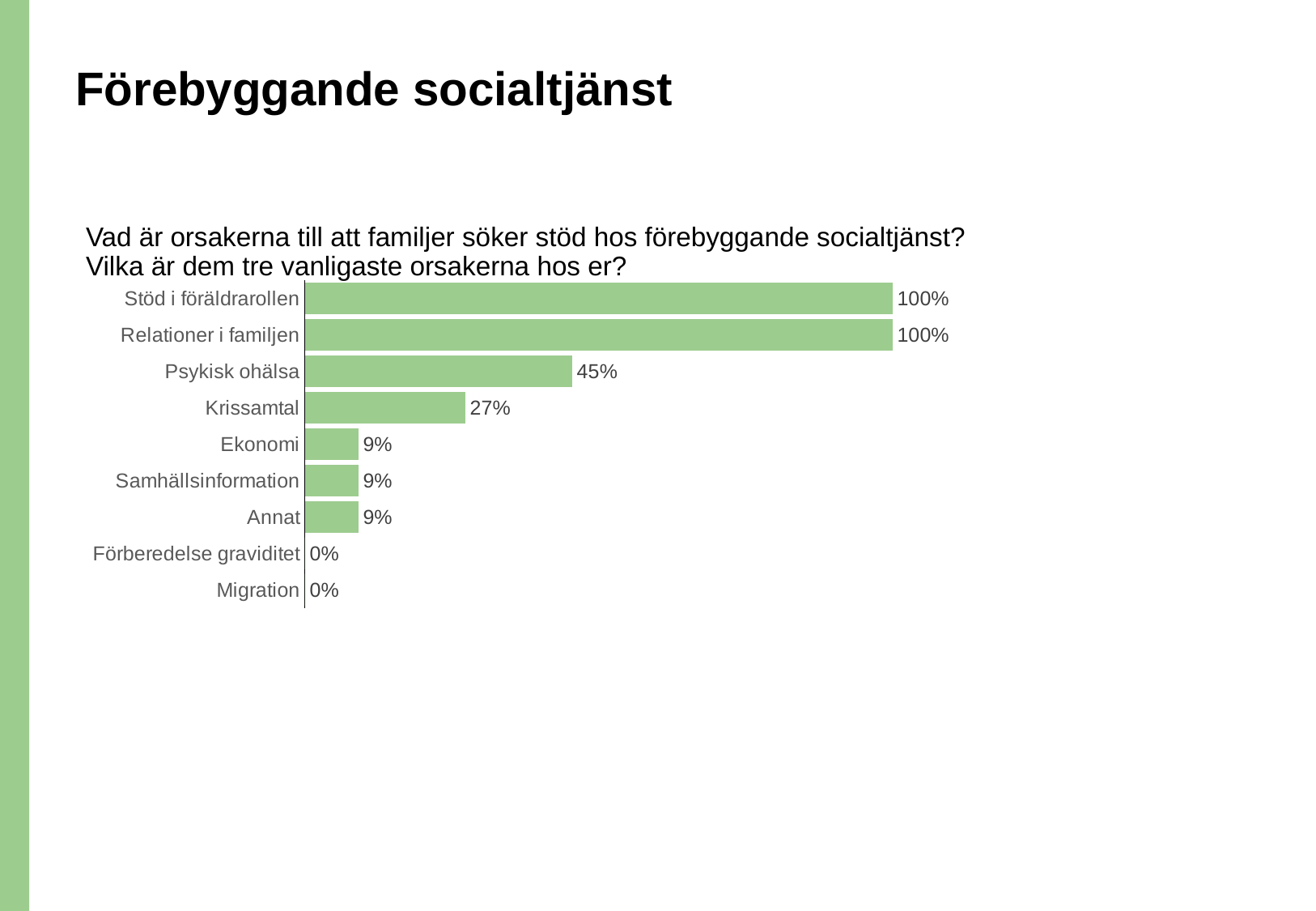
How many categories have a value of 100%? 2 Which category has the lowest value among those with a non-zero value? Ekonomi, Samhällsinformation and Annat (9%) What is the difference between the values for Stöd i föräldrarollen and Psykisk ohälsa? 55% What is the value for Psykisk ohälsa? 45% What colour are the bars in the chart? Green What kind of chart is shown on the slide? Bar chart What is the value for Ekonomi? 9% Which is larger, the value for Krissamtal or the value for Annat? Krissamtal What is the value for Migration? 0% What is the difference between the values for Psykisk ohälsa and Krissamtal? 18% How many categories are shown in the chart? 9 What is the value for Krissamtal? 27%